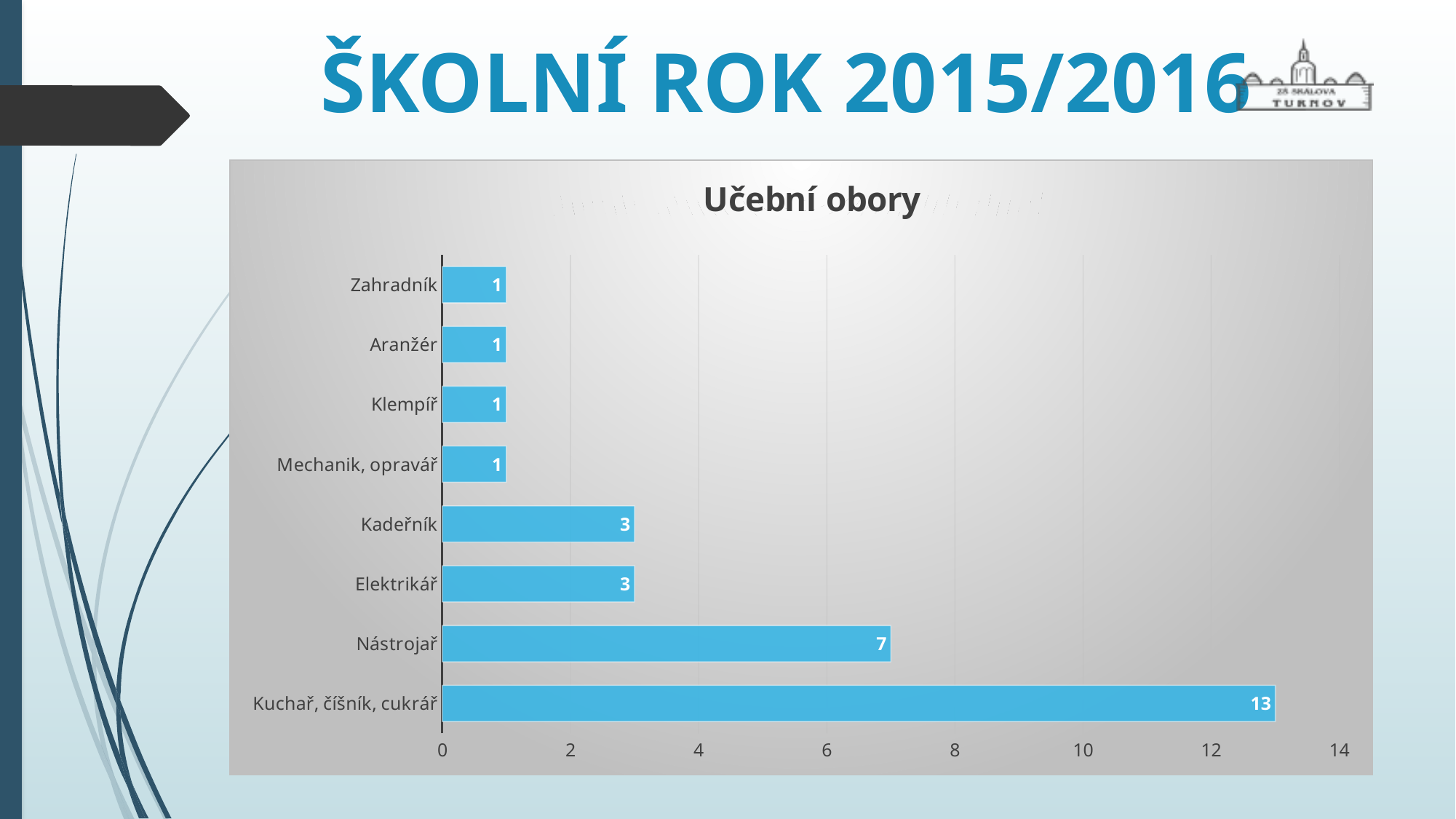
How many categories have a value of 1? 4 What is the value for Zahradník? 1 What is the difference between the values for Kuchař, číšník, cukrář and Nástrojař? 6 What kind of chart is shown? bar chart Is the value for Nástrojař greater or less than 6? greater Which category has the highest value? Kuchař, číšník, cukrář How many categories are shown in the chart? 8 What is the value for Kadeřník? 3 What is the value for Nástrojař? 7 Which is larger, the value for Elektrikář or the value for Klempíř? Elektrikář What is the value for Kuchař, číšník, cukrář? 13 What is the title of the chart? Učební obory